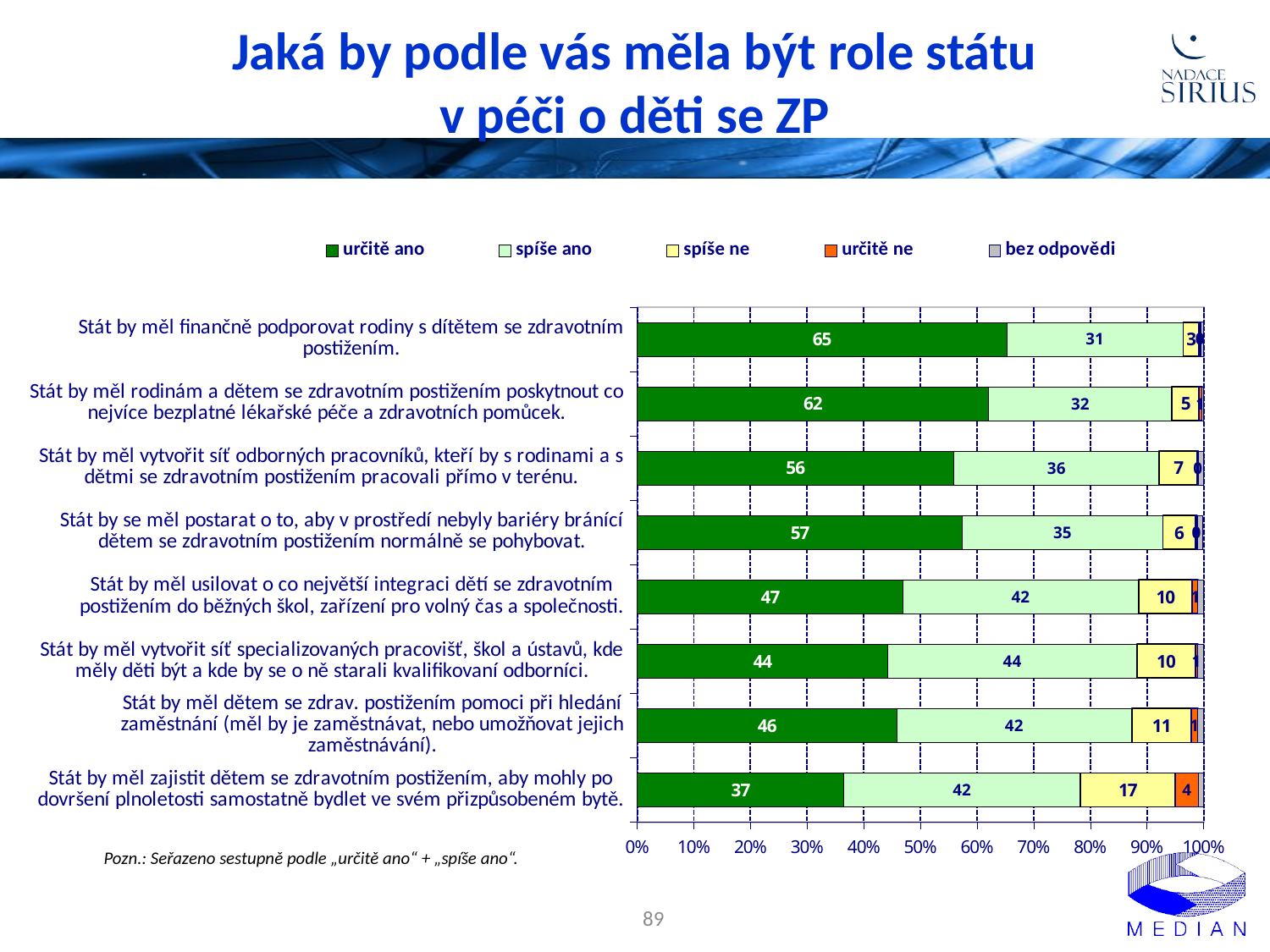
What is the "určitě ano" value for "Stát by měl finančně podporovat rodiny s dítětem se zdravotním postižením."? 65 What is the "spíše ne" value for "Stát by měl zajistit dětem se zdravotním postižením, aby mohly po dovršení plnoletosti samostatně bydlet ve svém přizpůsobeném bytě."? 17 What is the "spíše ano" value for "Stát by měl vytvořit síť odborných pracovníků, kteří by s rodinami a s dětmi se zdravotním postižením pracovali přímo v terénu."? 36 Which is larger: the "určitě ano" value for "Stát by se měl postarat o to, aby v prostředí nebyly bariéry bránící dětem se zdravotním postižením normálně se pohybovat." or for "Stát by měl usilovat o co největší integraci dětí se zdravotním postižením do běžných škol, zařízení pro volný čas a společnosti."? Stát by se měl postarat o to, aby v prostředí nebyly bariéry bránící dětem se zdravotním postižením normálně se pohybovat. How many series does the legend list? 5 Which statement has the lowest "určitě ano" value? Stát by měl zajistit dětem se zdravotním postižením, aby mohly po dovršení plnoletosti samostatně bydlet ve svém přizpůsobeném bytě. Which statement has the highest "určitě ano" value? Stát by měl finančně podporovat rodiny s dítětem se zdravotním postižením. According to the note below the chart, how are the statements ordered? Seřazeno sestupně podle „určitě ano“ + „spíše ano“ What is the "určitě ne" value for "Stát by měl zajistit dětem se zdravotním postižením, aby mohly po dovršení plnoletosti samostatně bydlet ve svém přizpůsobeném bytě."? 4 How many statements (categories) are plotted in the chart? 8 What is the difference between the "určitě ano" values for "Stát by měl finančně podporovat rodiny s dítětem se zdravotním postižením." and "Stát by měl rodinám a dětem se zdravotním postižením poskytnout co nejvíce bezplatné lékařské péče a zdravotních pomůcek."? 3 What type of chart is shown on the slide? stacked bar chart